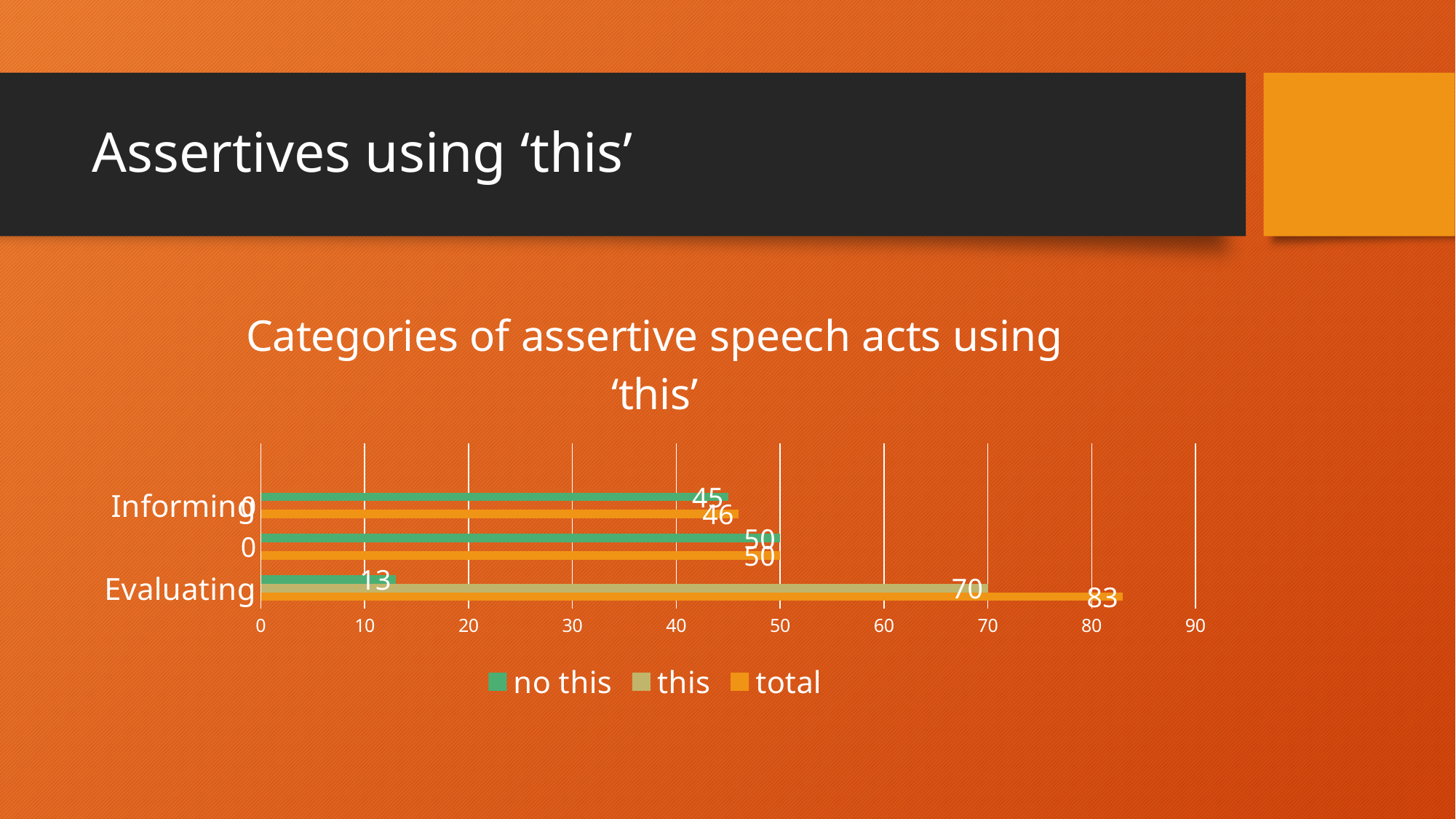
What is the 'total' value for Evaluating? 83 What is the 'no this' value for Evaluating? 13 Which category has the highest 'total' value? Evaluating What are the three legend entries of the chart? no this, this, total Which has the larger 'no this' value, Informing or Evaluating? Informing What is the 'no this' value for Informing? 45 What is the 'this' value for Evaluating? 70 How many series does the legend list? 3 What is the difference between the 'this' and 'no this' values for Evaluating? 57 What is the 'total' value for Informing? 46 What kind of chart is shown on the slide? bar chart Is the 'total' value for Evaluating greater or less than 80? greater